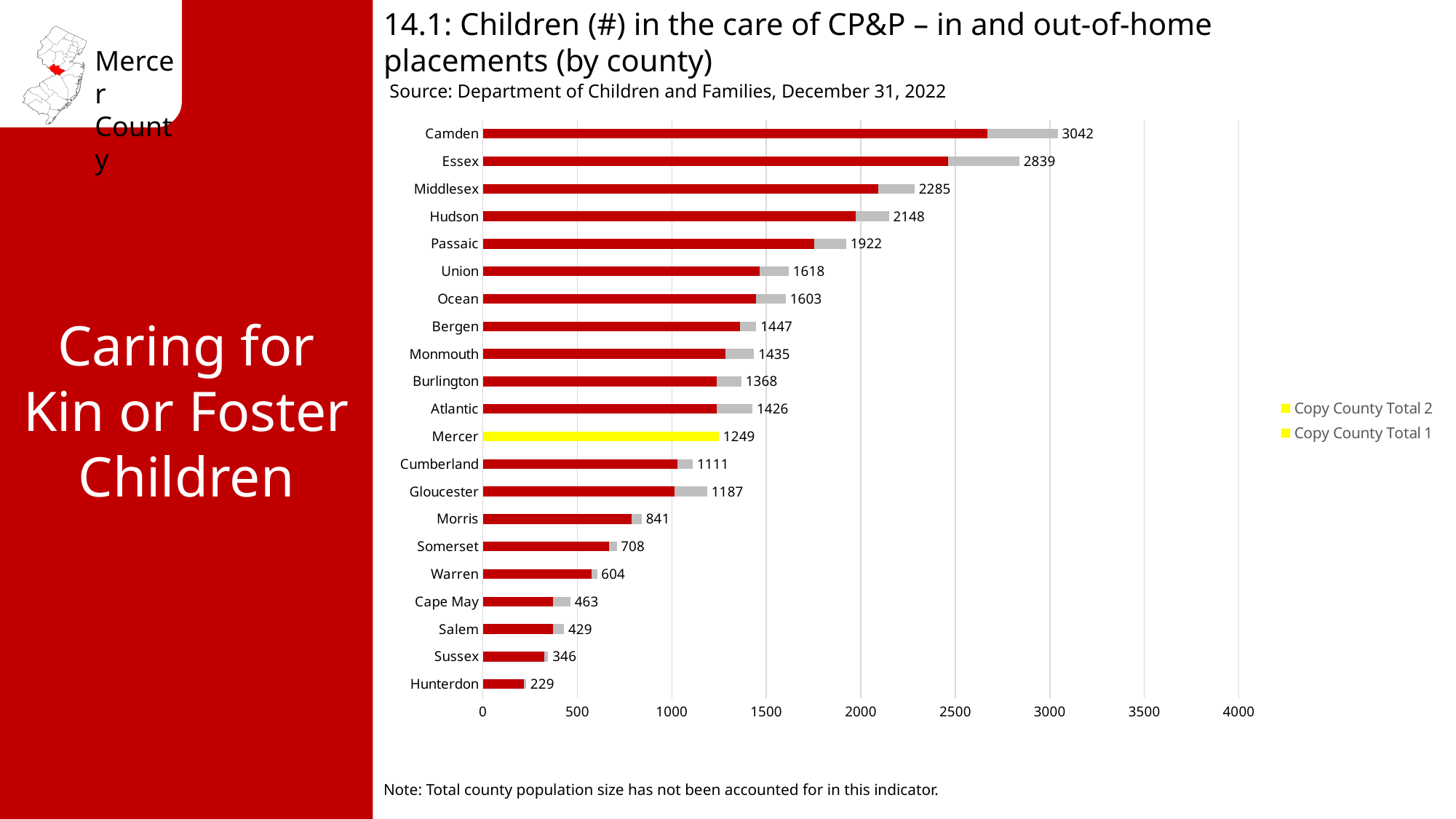
How many counties are shown in the chart? 21 Which county has a larger total, Atlantic or Burlington? Atlantic Which county has the highest total number of children in the care of CP&P? Camden What kind of chart is shown on the slide? Bar chart Which county has the lowest total number of children in the care of CP&P? Hunterdon Is the total for Passaic greater or less than 2000? less Which county's bar is highlighted in yellow? Mercer What is the total number of children in the care of CP&P for Camden? 3042 What is the difference between the totals for Camden and Essex? 203 What is the total number of children in the care of CP&P for Hunterdon? 229 What is the total number of children in the care of CP&P for Mercer? 1249 How many series does the legend list? 2